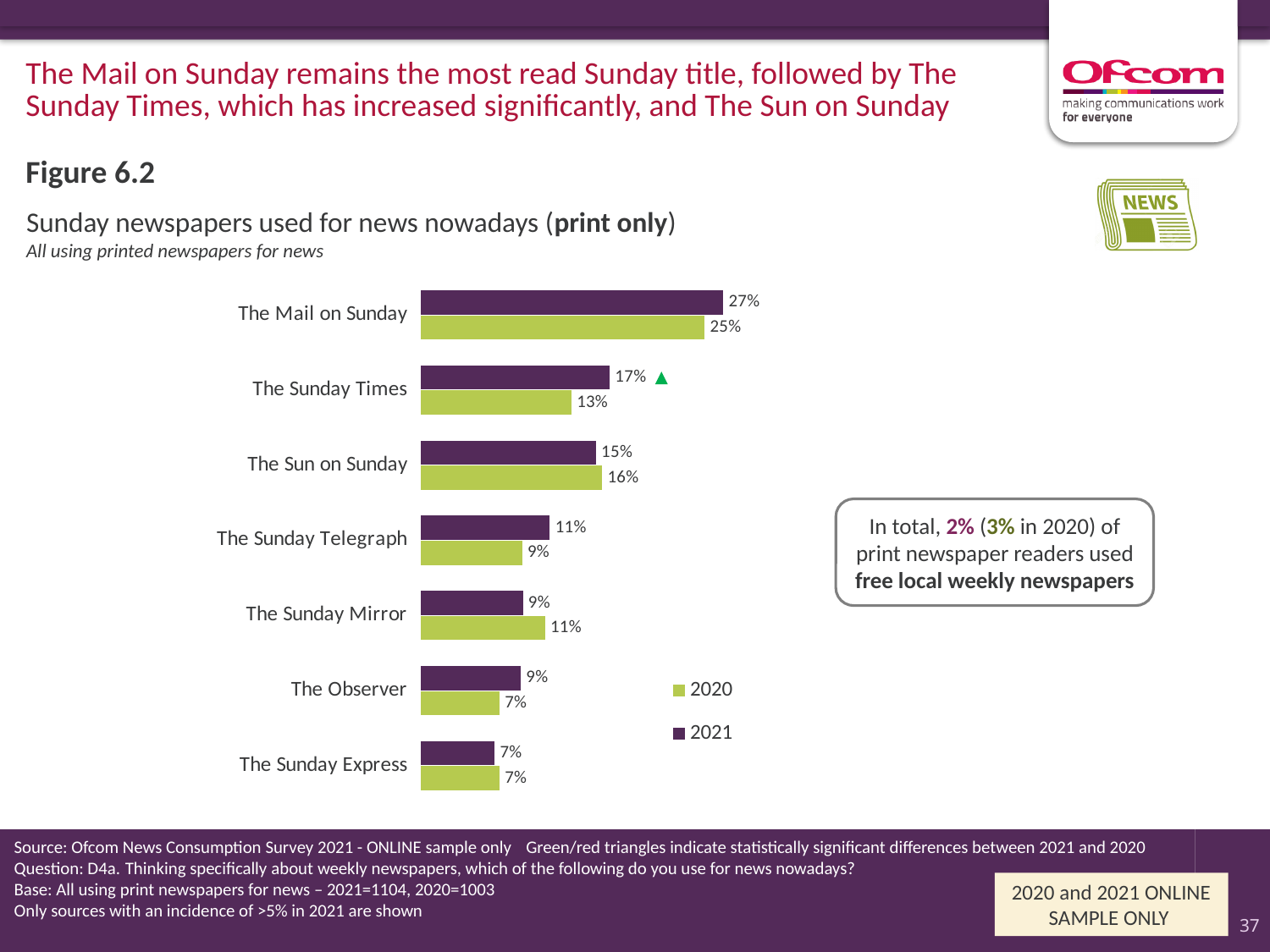
By how many percentage points did The Sunday Times increase from 2020 to 2021? 4 percentage points Which colour represents 2021 in the chart? Purple Which is larger for The Sunday Mirror: the 2020 value or the 2021 value? 2020 Which Sunday newspaper has the lowest value in 2021? The Sunday Express How many Sunday newspapers are shown in the chart? 7 How many series does the legend list? 2 What was the 2020 value for The Sun on Sunday? 16% What percentage of print newspaper readers used The Mail on Sunday for news in 2021? 27% What is the difference between the 2021 values for The Mail on Sunday and The Sunday Times? 10 percentage points What type of chart is used on this slide? Bar chart Which Sunday newspaper has the highest value in 2021? The Mail on Sunday What was the 2020 value for The Sunday Times? 13%